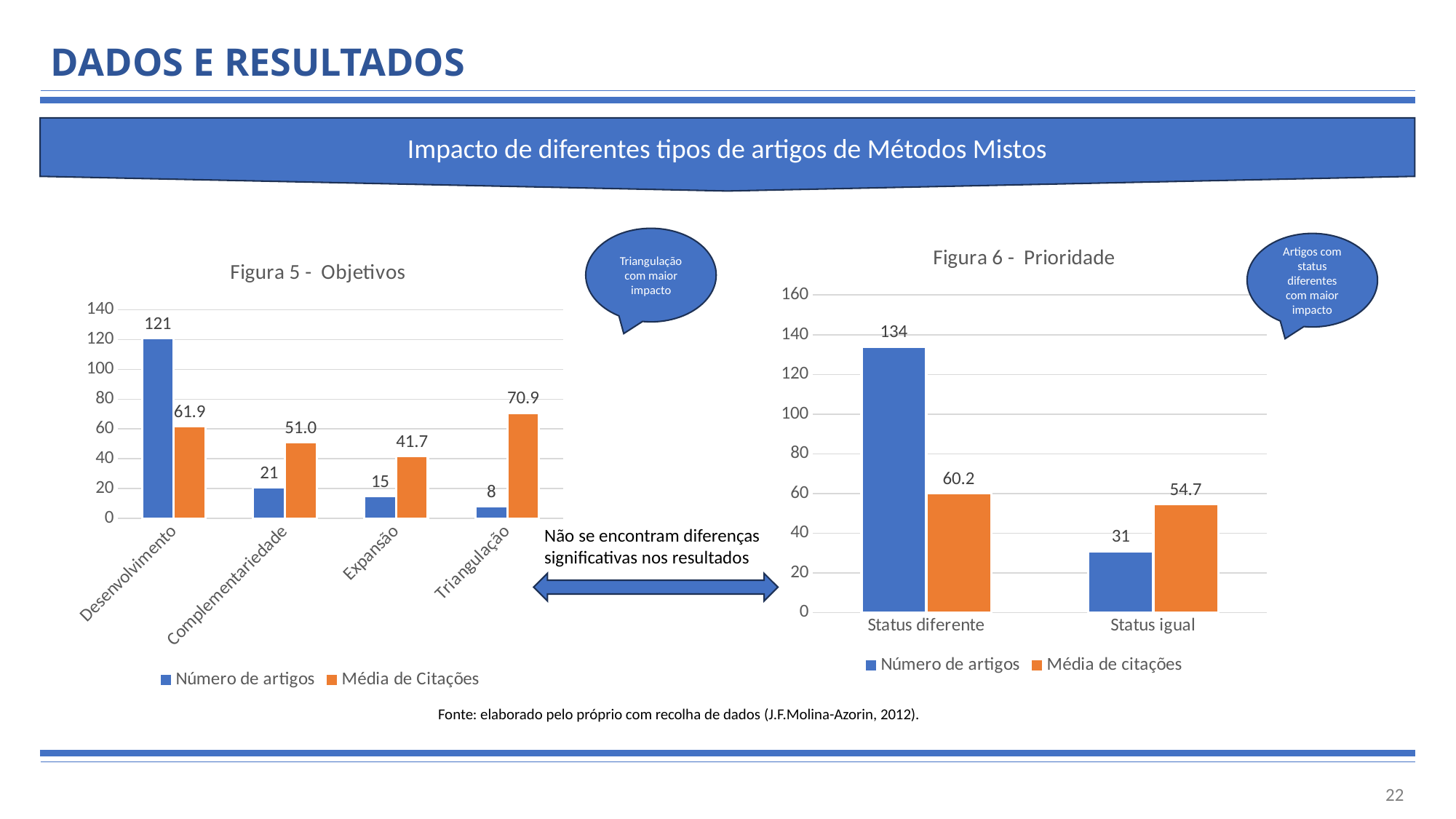
In the chart 'Figura 6 - Prioridade', what is the Número de artigos for Status diferente? 134 In the chart 'Figura 5 - Objetivos', what is the value of Número de artigos for Desenvolvimento? 121 In the chart 'Figura 5 - Objetivos', which category has the highest Média de Citações? Triangulação In the chart 'Figura 6 - Prioridade', what is the Média de citações for Status igual? 54.7 What type of chart is 'Figura 6 - Prioridade'? Bar chart In the chart 'Figura 5 - Objetivos', which category has the lowest Número de artigos? Triangulação In the chart 'Figura 6 - Prioridade', which is larger: the Média de citações for Status diferente or for Status igual? Status diferente In the chart 'Figura 5 - Objetivos', what is the difference in Número de artigos between Desenvolvimento and Complementariedade? 100 In the chart 'Figura 6 - Prioridade', what is the difference in Número de artigos between Status diferente and Status igual? 103 In the chart 'Figura 6 - Prioridade', how many series does the legend list? 2 In the chart 'Figura 5 - Objetivos', what is the Média de Citações for Triangulação? 70.9 In the chart 'Figura 5 - Objetivos', how many categories are shown on the x axis? 4